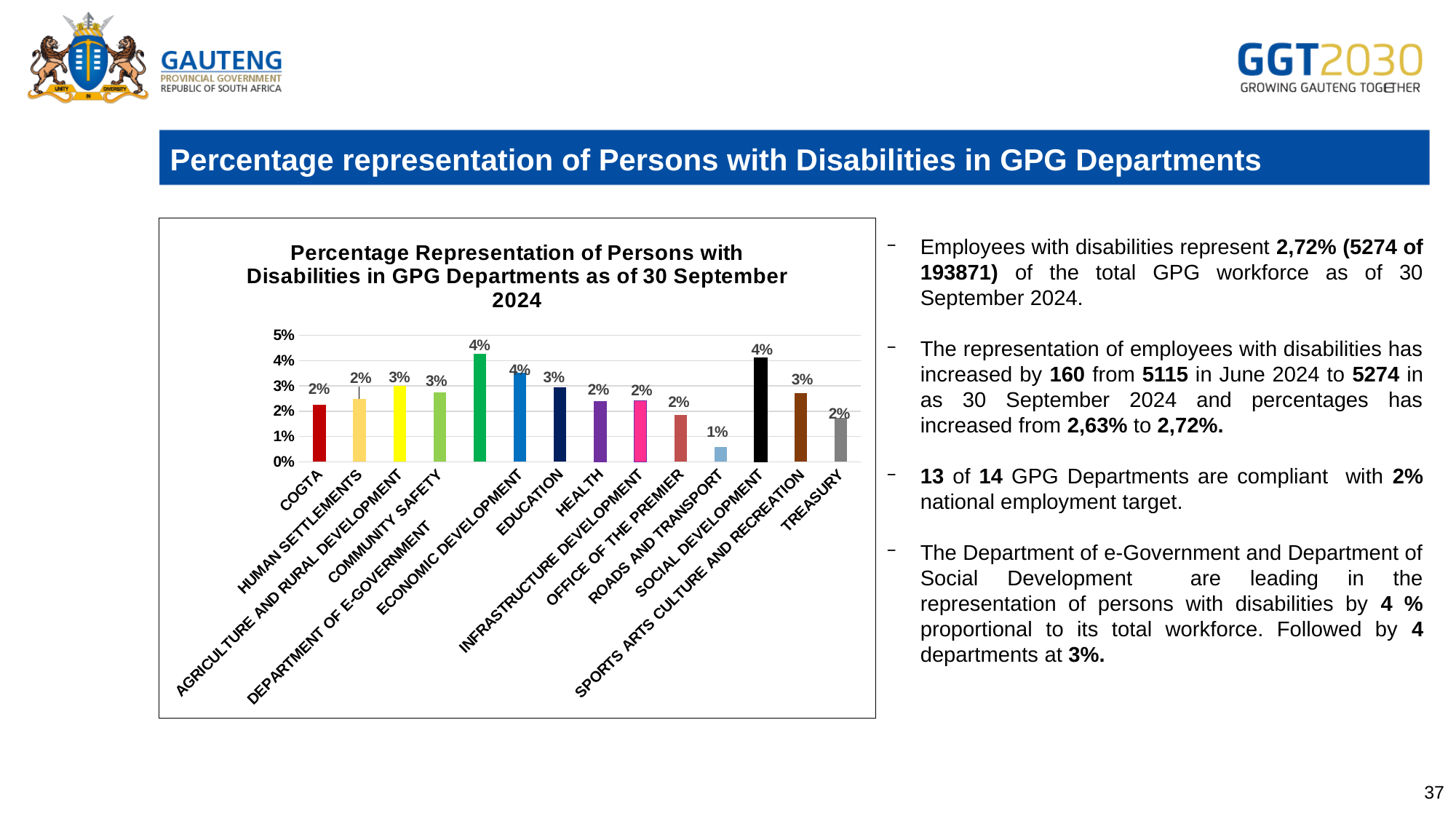
What kind of chart is shown on the slide? bar chart What is the difference between the percentage for SOCIAL DEVELOPMENT and the percentage for ROADS AND TRANSPORT? 3% Which department has the lowest percentage representation of persons with disabilities? ROADS AND TRANSPORT What is the percentage representation of persons with disabilities for SOCIAL DEVELOPMENT? 4% What is the percentage representation of persons with disabilities for EDUCATION? 3% Which has a higher percentage representation of persons with disabilities, SOCIAL DEVELOPMENT or ROADS AND TRANSPORT? SOCIAL DEVELOPMENT What is the percentage representation of persons with disabilities for ROADS AND TRANSPORT? 1% What is the percentage representation of persons with disabilities for COGTA? 2% What is the percentage representation of persons with disabilities for SPORTS ARTS CULTURE AND RECREATION? 3% Is the value for DEPARTMENT OF E-GOVERNMENT greater or less than 3%? greater How many departments are shown on the chart? 14 What is the title of the chart? Percentage Representation of Persons with Disabilities in GPG Departments as of 30 September 2024